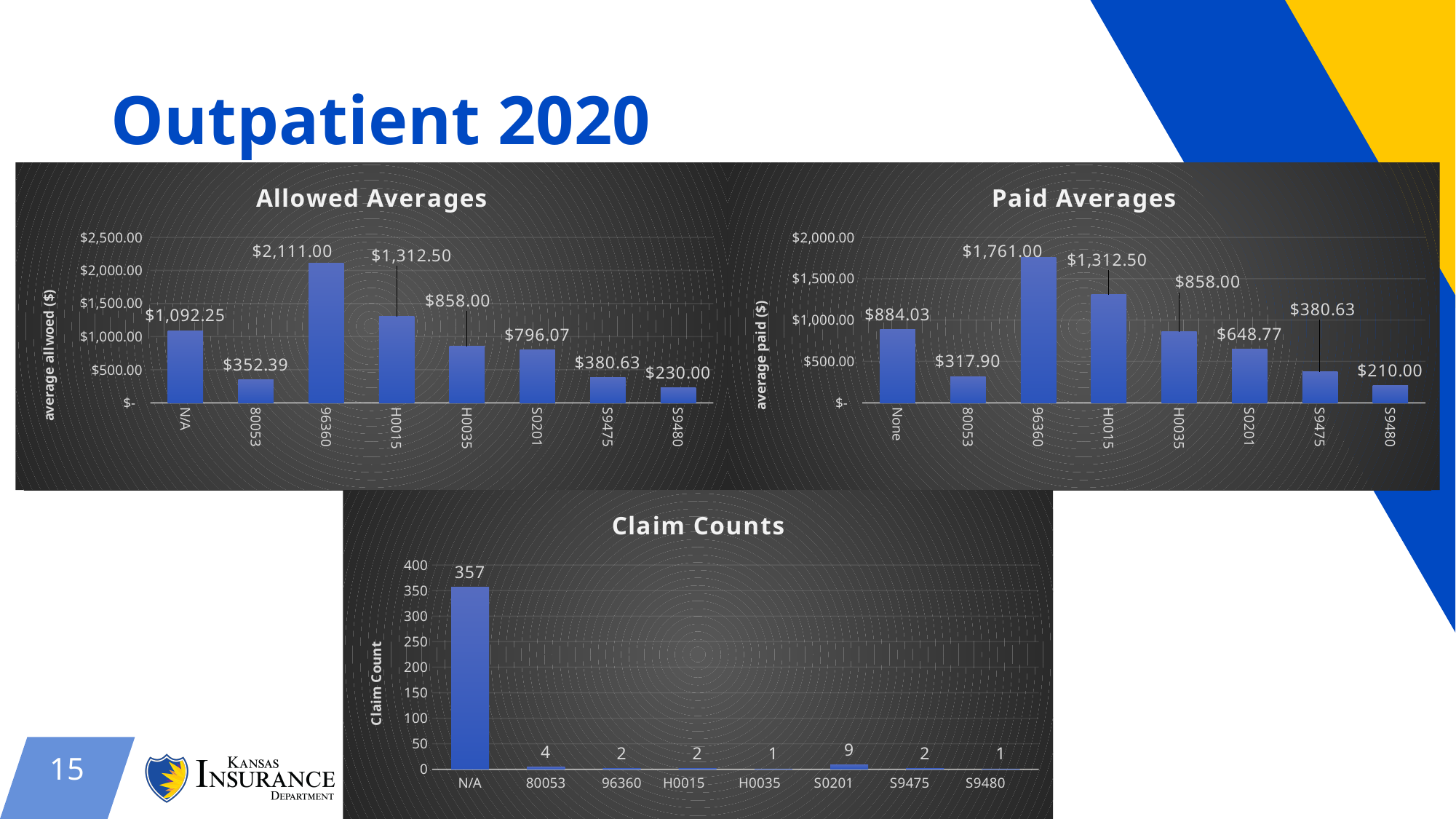
In the Allowed Averages chart, what is the difference between the values for 96360 and H0015? $798.50 In the Allowed Averages chart, which is larger, the value for N/A or the value for H0035? N/A In the Claim Counts chart, which category has the highest claim count? N/A In the Paid Averages chart, what is the difference between the values for None and 80053? $566.13 In the Claim Counts chart, what is the claim count for S0201? 9 In the Allowed Averages chart, which category has the lowest value? S9480 What is the y-axis label of the Allowed Averages chart? average allwoed ($) How many categories are shown in the Claim Counts chart? 8 In the Allowed Averages chart, what is the value for 96360? $2,111.00 What type of chart is the Paid Averages chart? Bar chart In the Paid Averages chart, what is the value for S0201? $648.77 In the Paid Averages chart, which category has the highest value? 96360